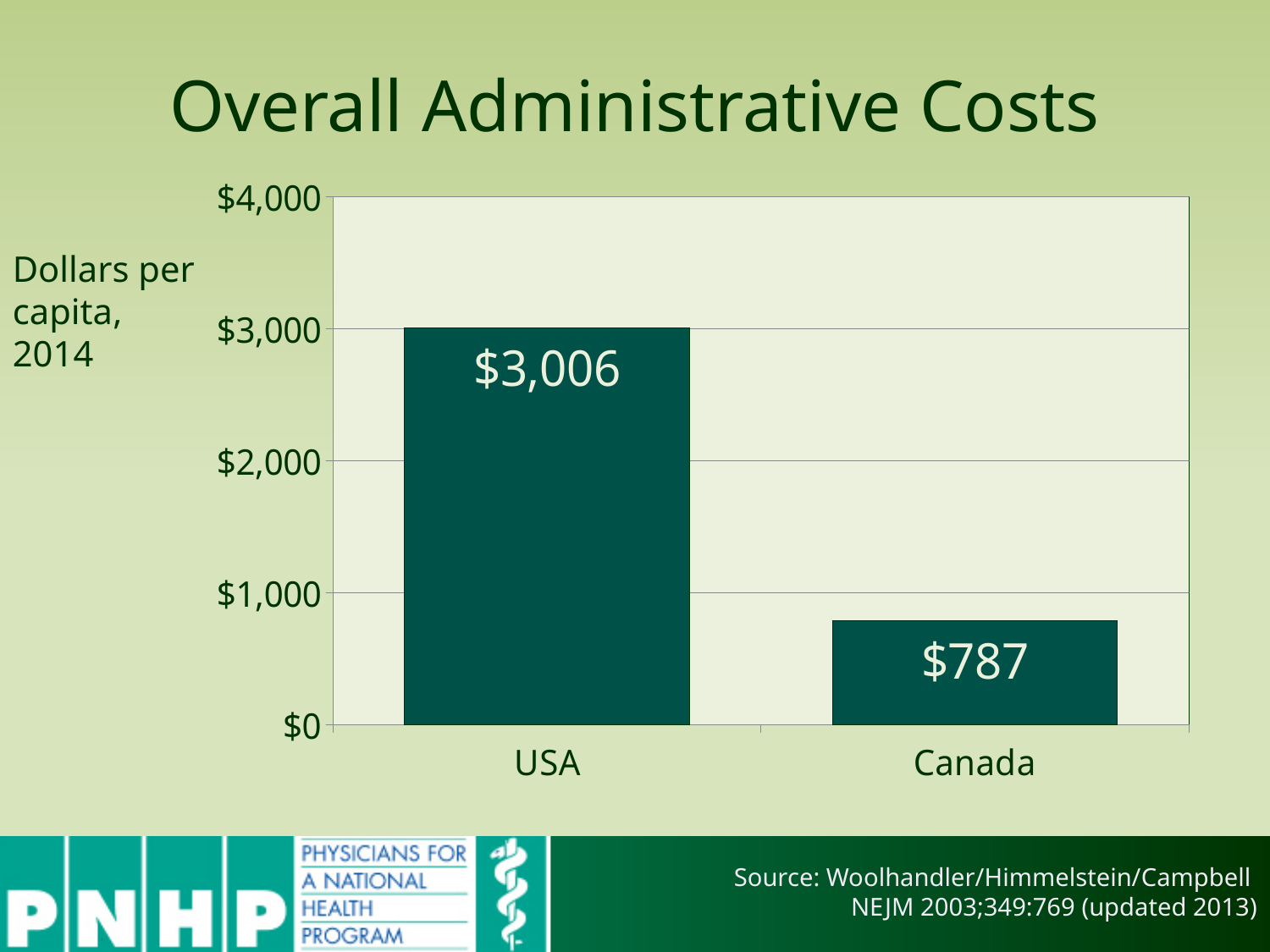
What is the difference between the values for USA and Canada? $2,219 What kind of chart is shown on the slide? bar chart Is the value for Canada greater or less than $1,000? less What is the value for Canada? $787 What is the value for USA? $3,006 Which category has the highest value? USA What is the title of the chart? Overall Administrative Costs Which is larger, the value for USA or the value for Canada? USA Which category has the lowest value? Canada What unit does the y-axis label describe? Dollars per capita, 2014 How many categories are shown on the chart? 2 Is the value for USA greater or less than $3,000? greater